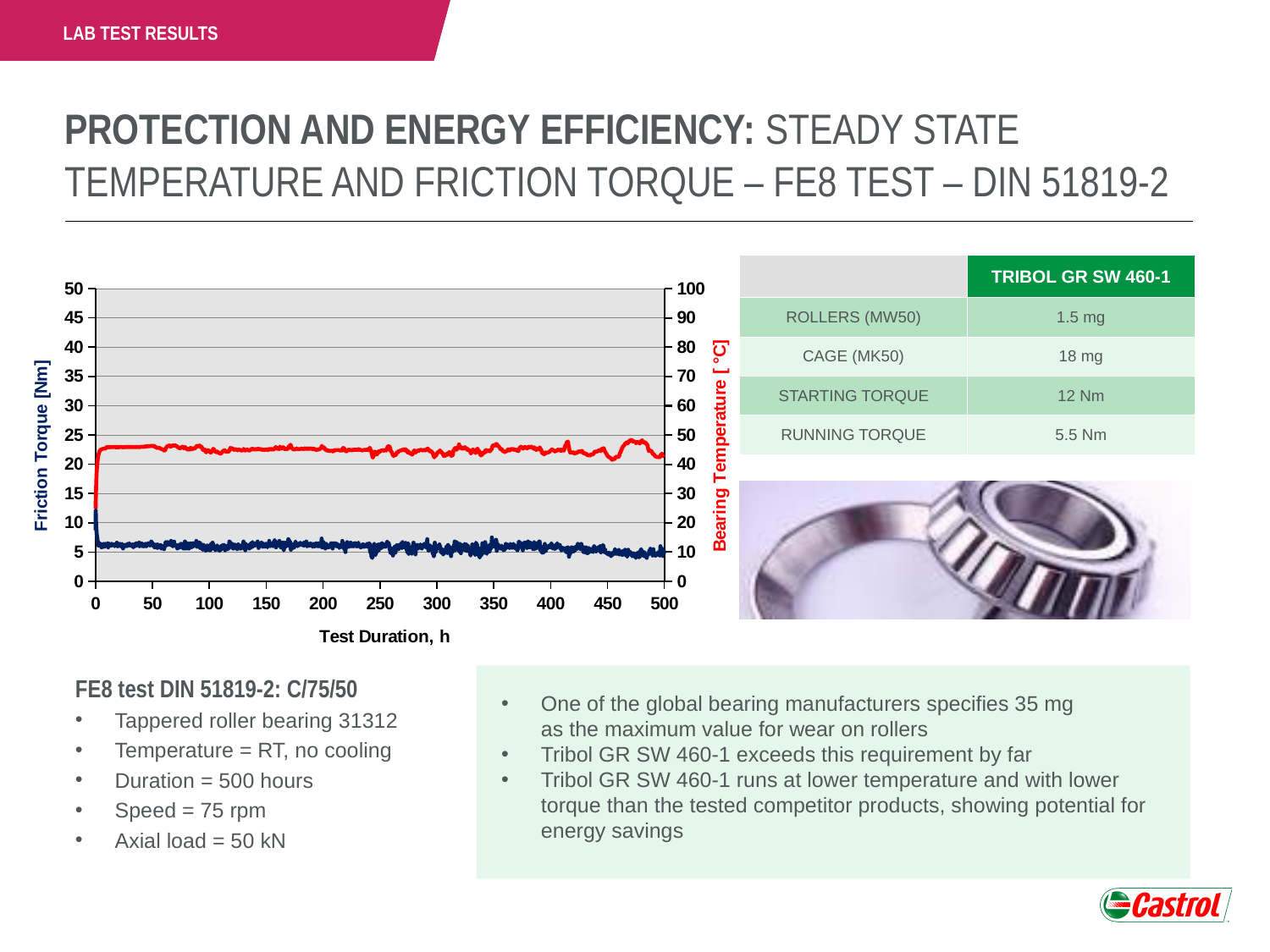
Is the value of the red line at 250 h greater or less than 60 on the right (Bearing Temperature) axis? less Is the value of the blue line at 250 h greater or less than 10 on the left (Friction Torque) axis? less Which line sits higher on the chart across the test duration, the red line or the blue line? the red line After the initial rise, does the red line rise steadily, fall steadily, or stay roughly flat from 50 h to 500 h? stay roughly flat How many lines are plotted on the chart? 2 What kind of chart is shown on the slide? line chart What is the label of the x axis of the chart? Test Duration, h What is the highest tick value shown on the x axis of the chart? 500 Is the value of the red line at 300 h greater or less than 30 on the right (Bearing Temperature) axis? greater What is the label of the left y axis of the chart? Friction Torque [Nm] What is the highest tick value shown on the left y axis (Friction Torque) of the chart? 50 What is the highest tick value shown on the right y axis (Bearing Temperature) of the chart? 100